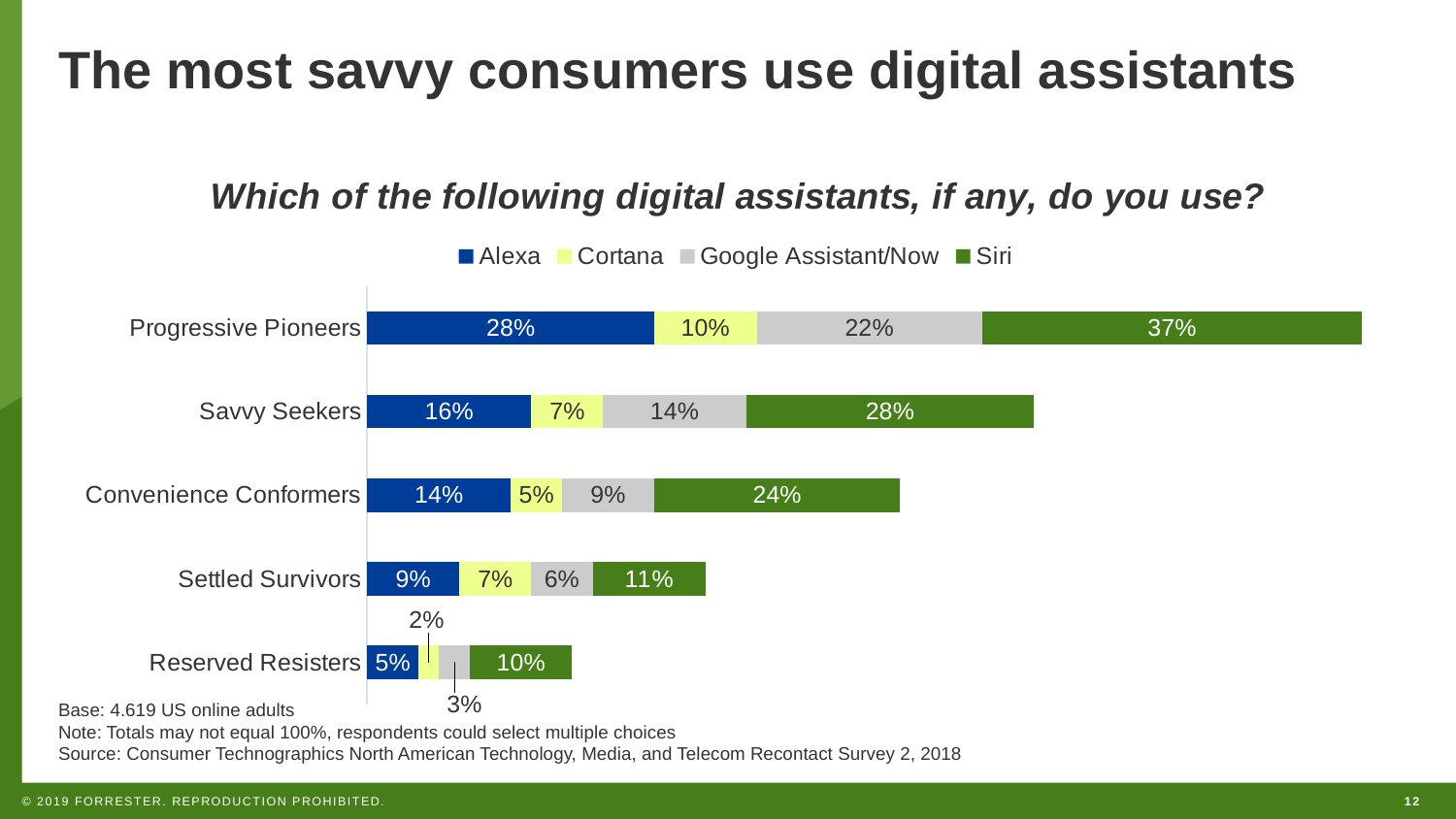
Which segment has the lowest percentage of Alexa users? Reserved Resisters What is the total of the stacked bar for Settled Survivors? 33% What percentage of Convenience Conformers use Google Assistant/Now? 9% Which segment has the highest percentage of Siri users? Progressive Pioneers How many consumer segments are shown on the chart? 5 What type of chart is shown on the slide? Stacked bar chart Which is larger for Settled Survivors: the Alexa percentage or the Siri percentage? Siri How many digital assistants does the legend list? 4 What percentage of Savvy Seekers use Alexa? 16% What percentage of Progressive Pioneers use Siri? 37% What is the difference between the Siri percentage for Progressive Pioneers and for Savvy Seekers? 9% What percentage of Reserved Resisters use Cortana? 2%